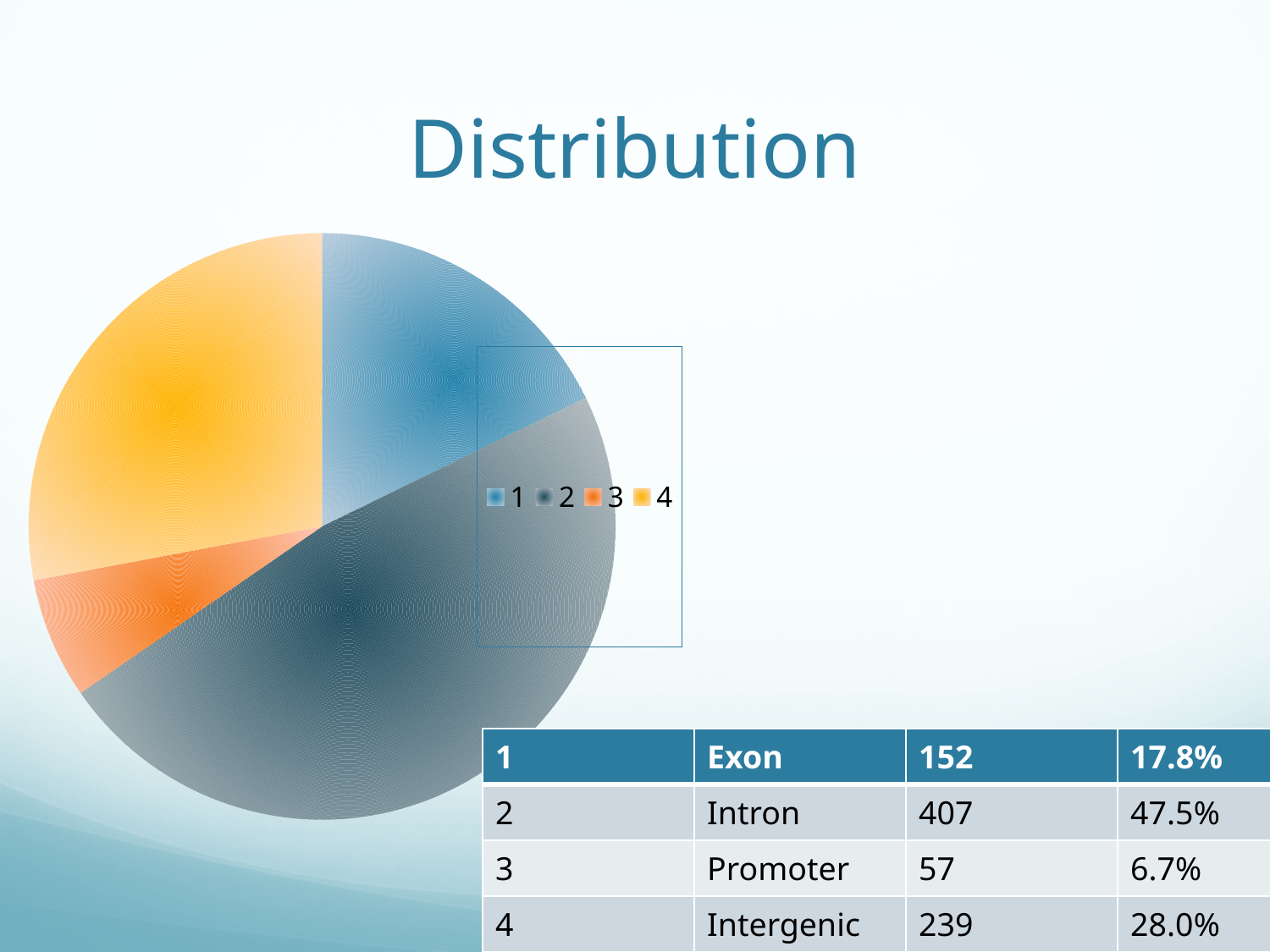
According to the table, what is the count for Promoter (slice 3)? 57 What kind of chart is shown on the slide? pie chart According to the table, what share of the pie does Intron (slice 2) represent? 47.5% Which slice of the pie chart is the largest? 2 (Intron) According to the table, what share of the pie does Intergenic (slice 4) represent? 28.0% According to the table, what is the count for Exon (slice 1)? 152 What is the title of the slide containing the pie chart? Distribution Which slice of the pie chart is the smallest? 3 (Promoter) Which slice is larger in the pie chart, slice 2 or slice 3? 2 Which slice is larger in the pie chart, slice 1 or slice 4? 4 How many entries does the pie chart's legend list? 4 How many slices does the pie chart have? 4